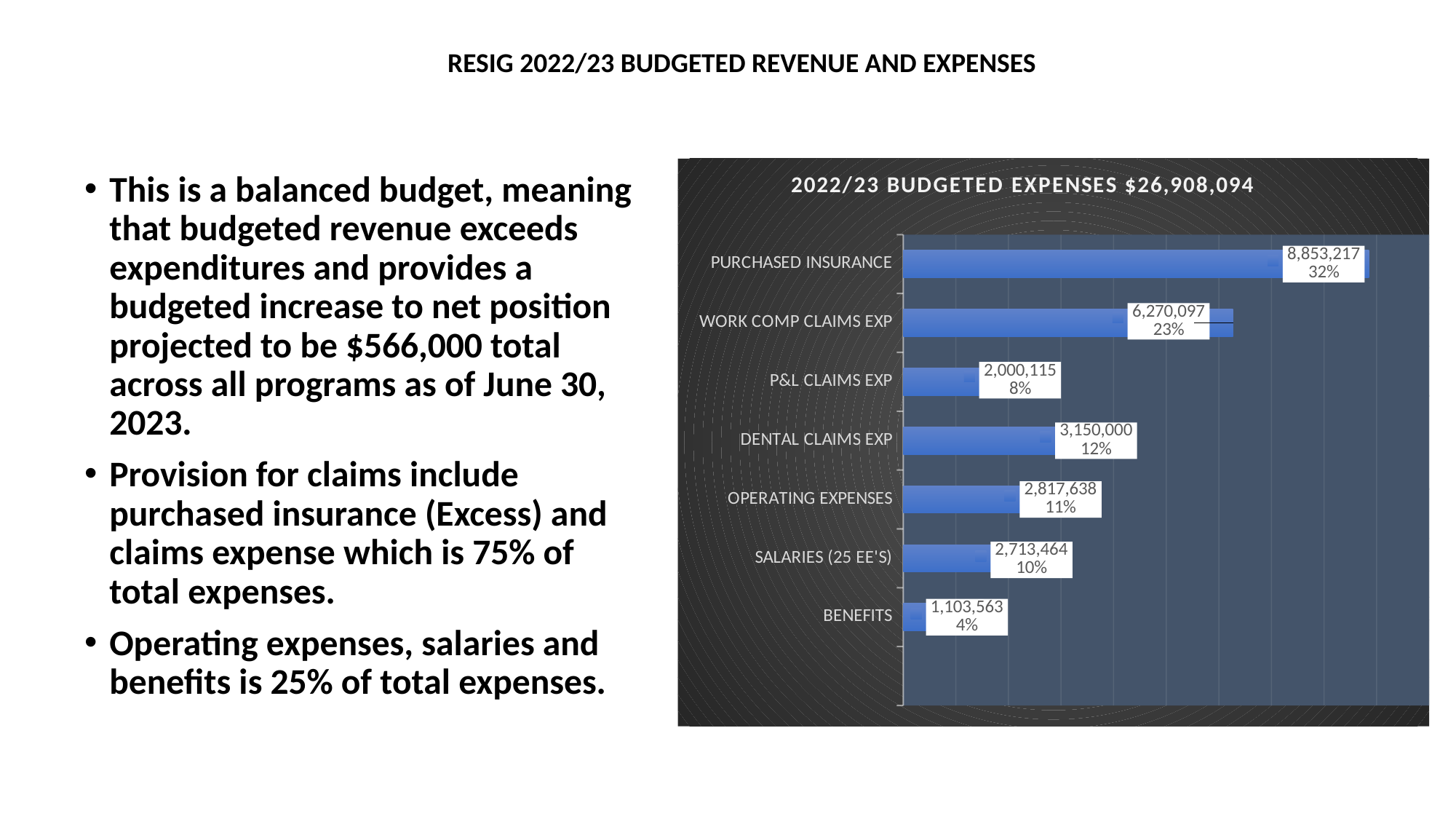
What is the budgeted value for WORK COMP CLAIMS EXP? 6,270,097 What is the budgeted value for BENEFITS? 1,103,563 What kind of chart is shown on the slide? Bar chart Which category has the highest budgeted expense? PURCHASED INSURANCE What percentage of budgeted expenses is DENTAL CLAIMS EXP? 12% What is the difference between PURCHASED INSURANCE and WORK COMP CLAIMS EXP? 2,583,120 What is the total of budgeted expenses given in the chart title? $26,908,094 How many expense categories are shown in the chart? 7 What is the budgeted value for PURCHASED INSURANCE? 8,853,217 Which category has the lowest budgeted expense? BENEFITS Which is larger, OPERATING EXPENSES or SALARIES (25 EE'S)? OPERATING EXPENSES What percentage of budgeted expenses is P&L CLAIMS EXP? 8%